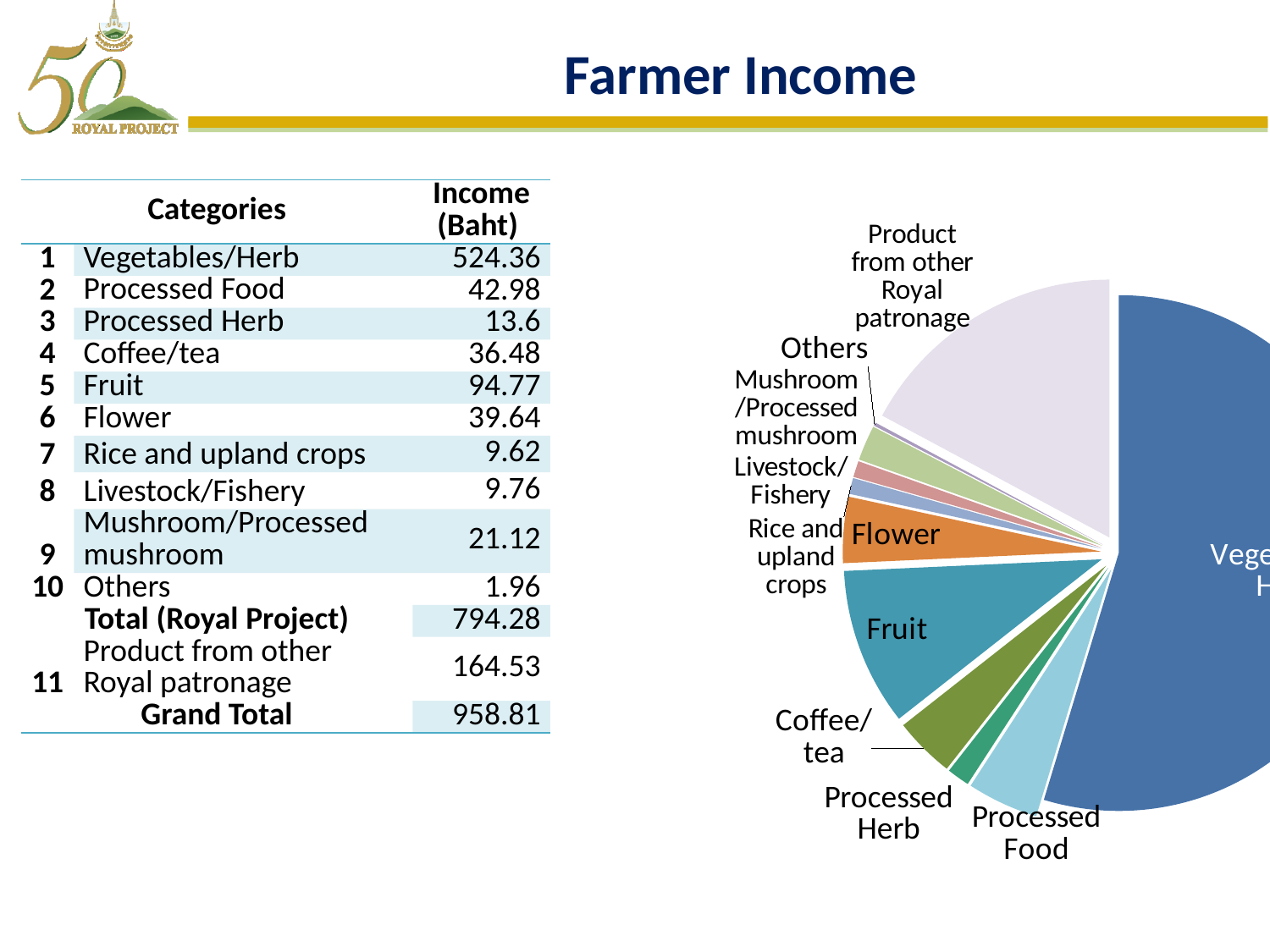
Which is larger, the income for Fruit or for Flower? Fruit What is the title of the slide containing the pie chart? Farmer Income What is the income (Baht) for Coffee/tea? 36.48 What is the difference in income (Baht) between Fruit and Flower? 55.13 What is the income (Baht) for Product from other Royal patronage? 164.53 Which is larger, the income for Product from other Royal patronage or for Fruit? Product from other Royal patronage What is the Total (Royal Project) income (Baht)? 794.28 How many slices does the pie chart have? 11 Which category has the largest slice of the pie chart? Vegetables/Herb What kind of chart is shown on the slide? pie chart Which category has the smallest slice of the pie chart? Others What is the Grand Total income (Baht)? 958.81